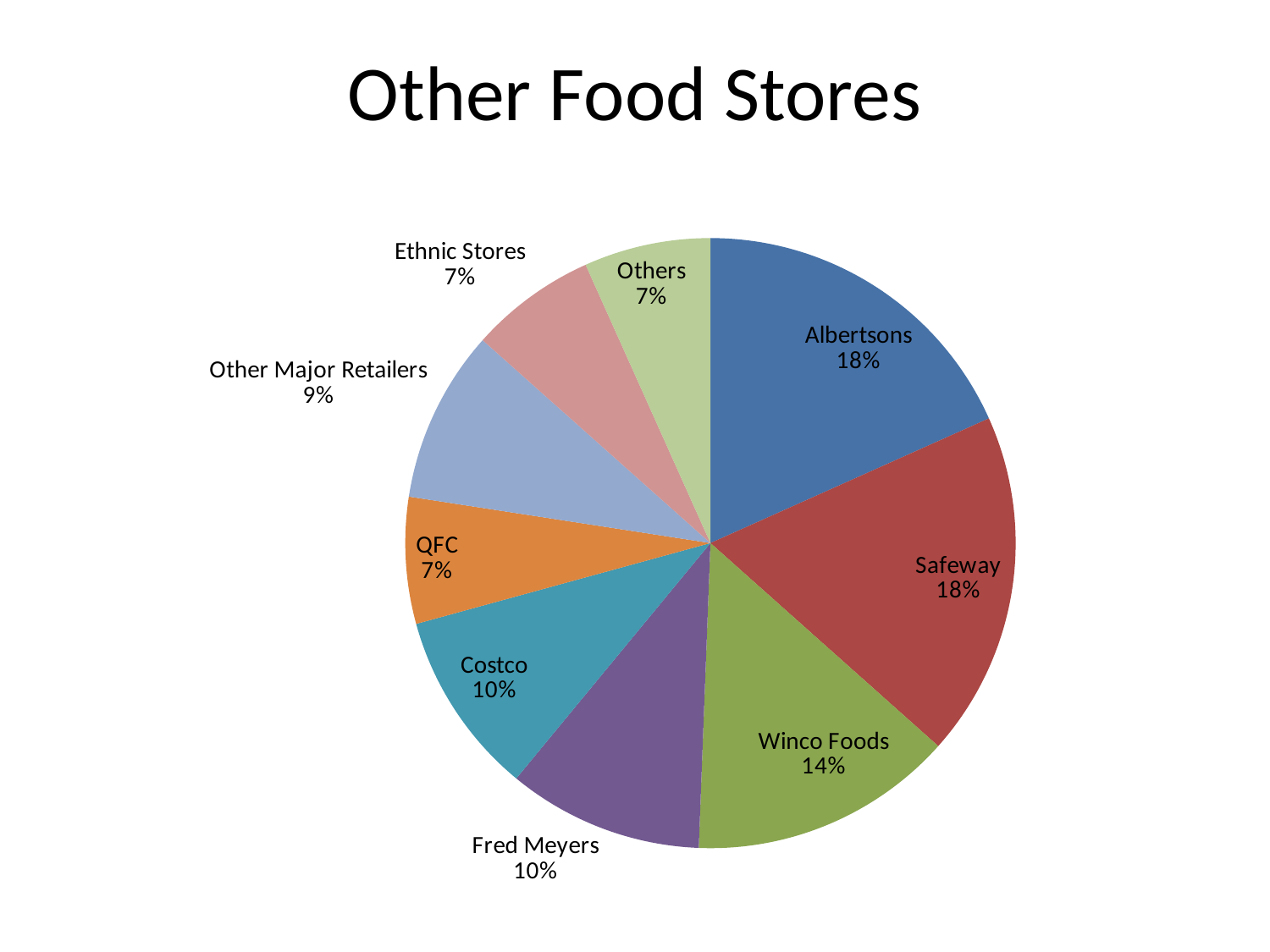
What is the difference in percentage points between Winco Foods and Fred Meyers? 4% Which has a larger share, Other Major Retailers or Ethnic Stores? Other Major Retailers What share of the pie does Winco Foods hold? 14% What is the value shown for Other Major Retailers? 9% What is the largest percentage shown on the pie chart? 18% How many slices does the pie chart have? 9 Which has a larger share, Winco Foods or Costco? Winco Foods What percentage is shown for QFC? 7% What percentage is shown for Costco? 10% What kind of chart is shown on the slide? Pie chart What is the difference in percentage points between Albertsons and Costco? 8% What is the value shown for Safeway? 18%